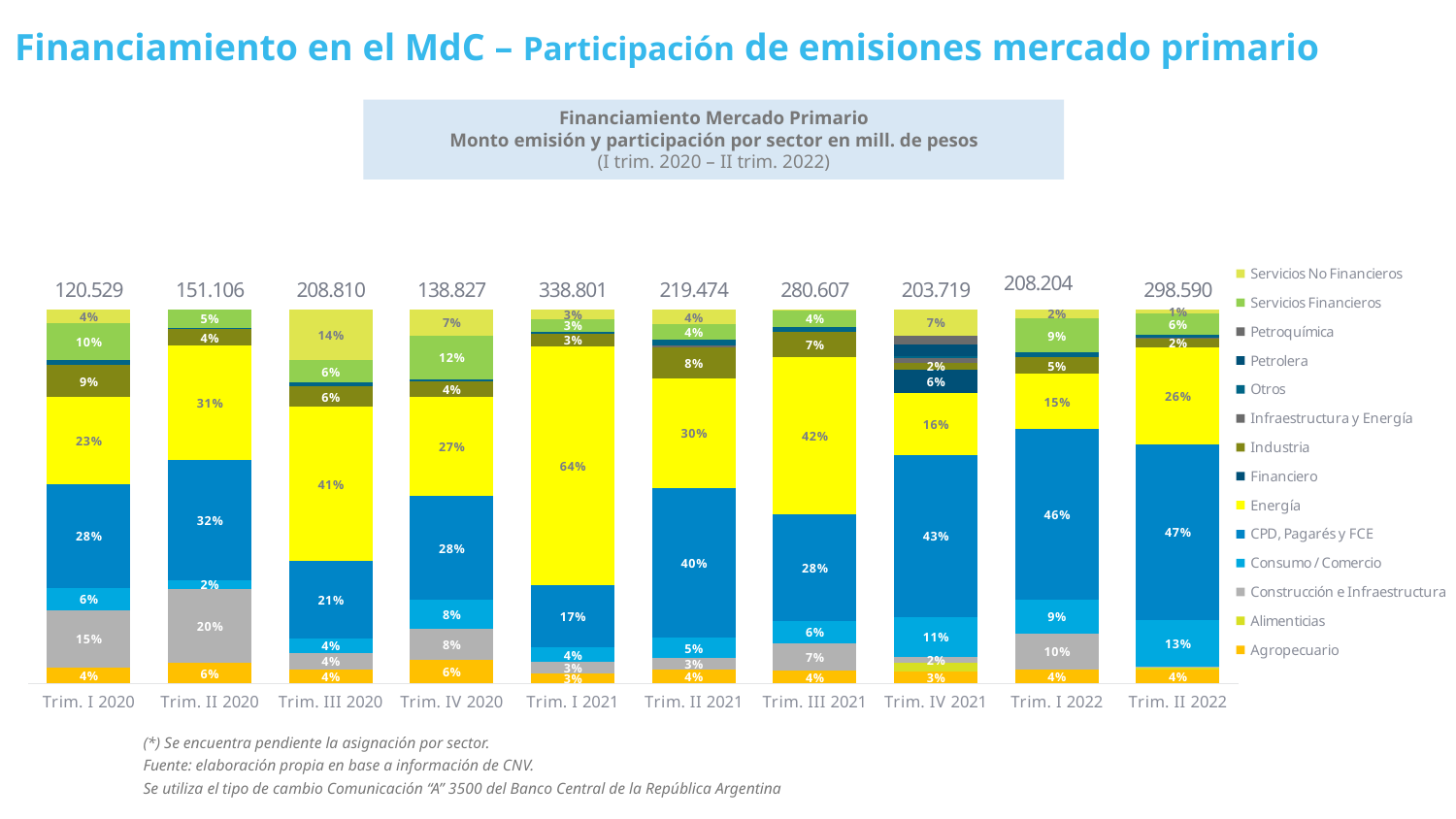
What kind of chart is shown on the slide? Stacked bar chart What is the total emission amount shown above the bar for Trim. I 2021? 338.801 What share does Construcción e Infraestructura have in Trim. II 2020? 20% In Trim. III 2020, which has the larger share: Energía or CPD, Pagarés y FCE? Energía How many sectors does the legend list? 14 In which quarter does Energía reach its highest share? Trim. I 2021 How many quarters (bars) are plotted on the chart? 10 By how many percentage points does the CPD, Pagarés y FCE share in Trim. I 2022 exceed its share in Trim. I 2020? 18 percentage points Which quarter has the lowest total emission amount? Trim. I 2020 What share does Energía have in Trim. I 2021? 64% What share does CPD, Pagarés y FCE have in Trim. II 2022? 47% Which quarter has the highest total emission amount? Trim. I 2021